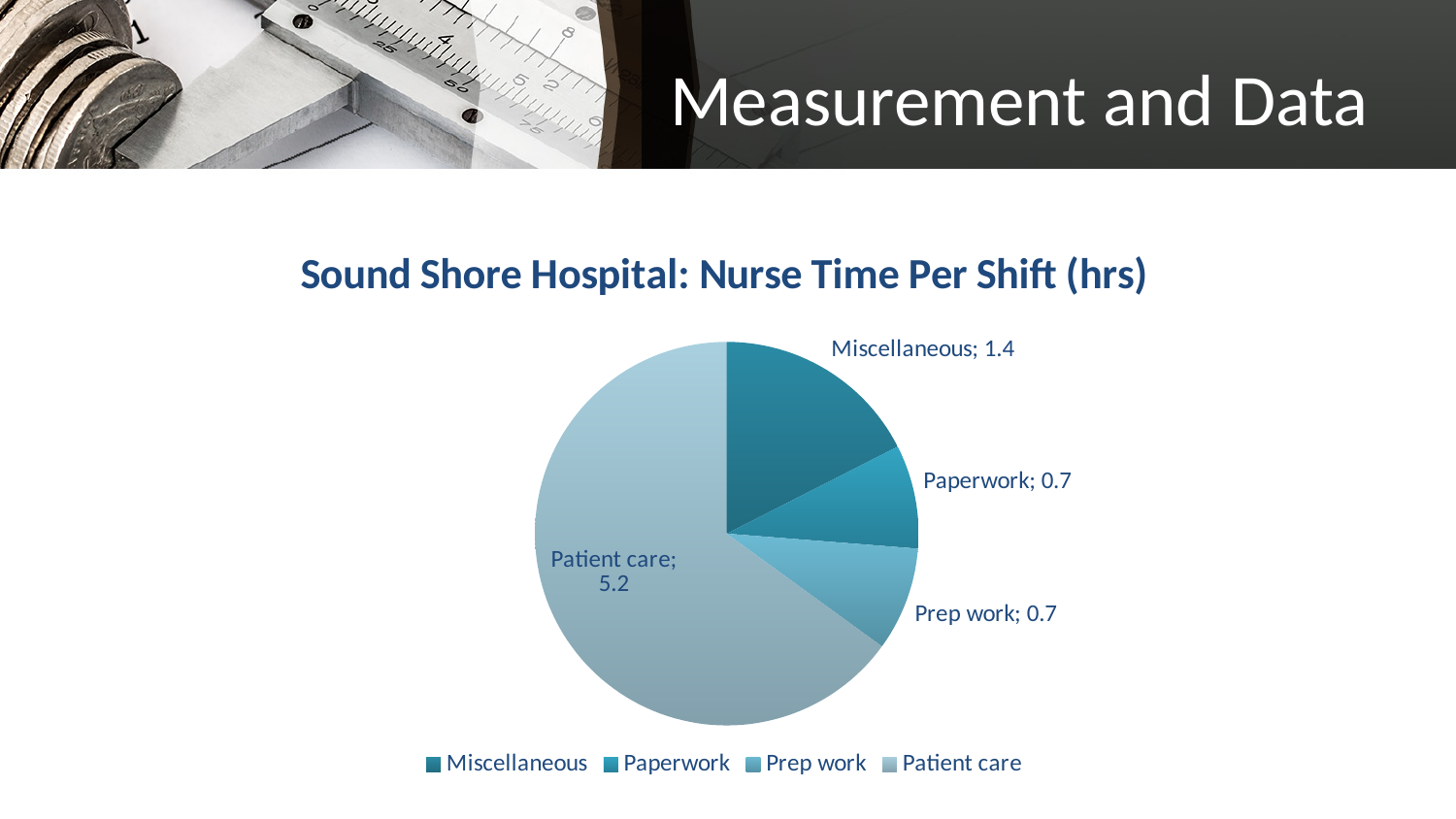
What is the difference in hours between Patient care and Miscellaneous? 3.8 Which category takes the most nurse time per shift? Patient care What share of the total nurse time per shift is Patient care? 65% What type of chart is shown on the slide? Pie chart How many hours per shift are spent on Prep work? 0.7 What is the total number of hours across all four categories? 8.0 Which is larger, Miscellaneous or Paperwork? Miscellaneous How many hours per shift are spent on Patient care? 5.2 How many categories does the pie chart show? 4 How many hours per shift are spent on Paperwork? 0.7 How many hours per shift are spent on Miscellaneous? 1.4 What is the title of the chart? Sound Shore Hospital: Nurse Time Per Shift (hrs)